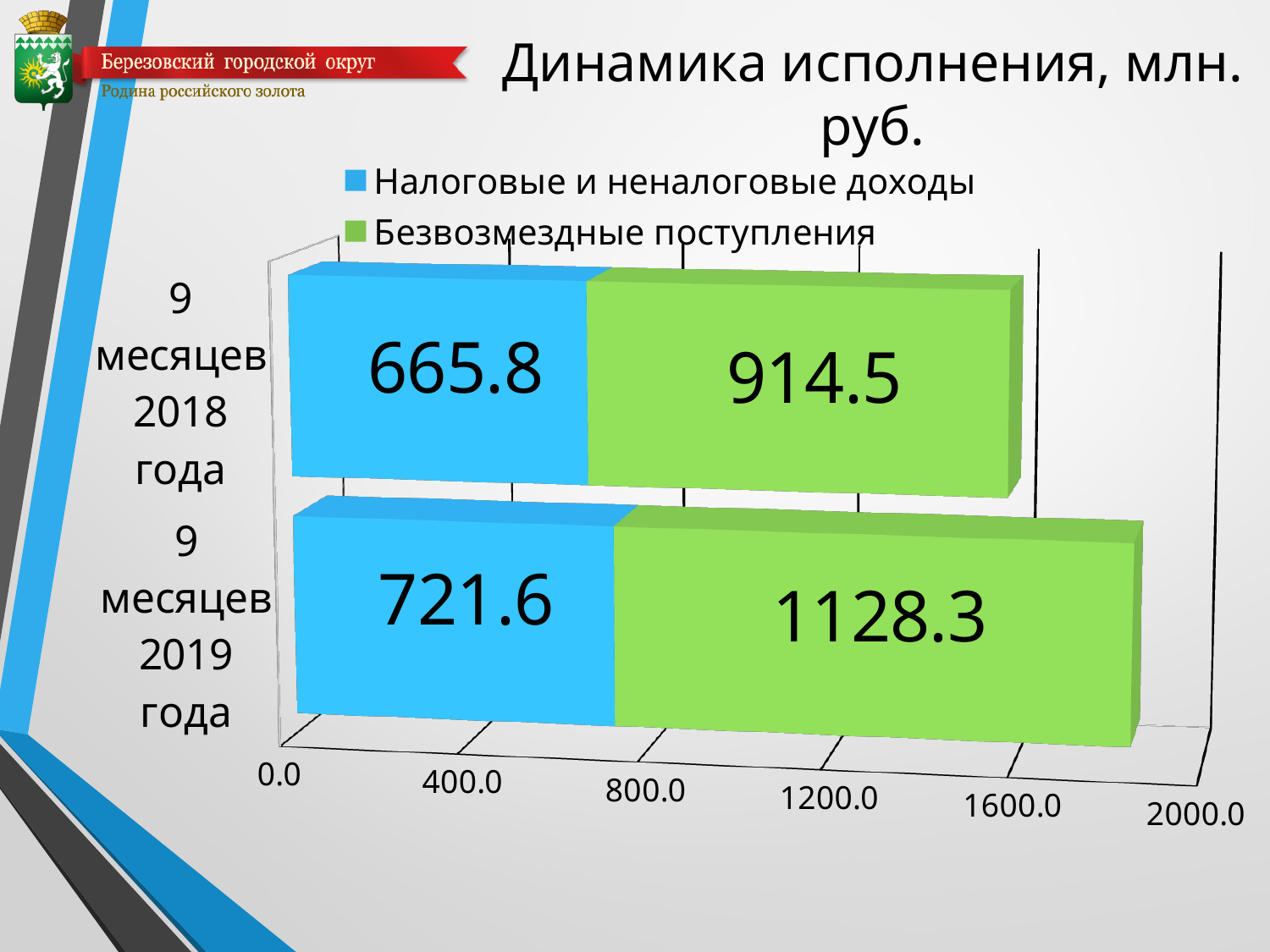
Which period has the higher value for Безвозмездные поступления? 9 месяцев 2019 года What is the difference between Безвозмездные поступления for 9 месяцев 2019 года and 9 месяцев 2018 года? 213.8 What kind of chart is shown on the slide? Stacked bar chart How many series does the legend list? 2 What is the value of Налоговые и неналоговые доходы for 9 месяцев 2018 года? 665.8 What is the value of Налоговые и неналоговые доходы for 9 месяцев 2019 года? 721.6 What is the value of Безвозмездные поступления for 9 месяцев 2019 года? 1128.3 Which period has the lower value for Налоговые и неналоговые доходы? 9 месяцев 2018 года What is the total of the stacked bar for 9 месяцев 2018 года? 1580.3 What is the total of the stacked bar for 9 месяцев 2019 года? 1849.9 What is the value of Безвозмездные поступления for 9 месяцев 2018 года? 914.5 What is the difference between Налоговые и неналоговые доходы for 9 месяцев 2019 года and 9 месяцев 2018 года? 55.8